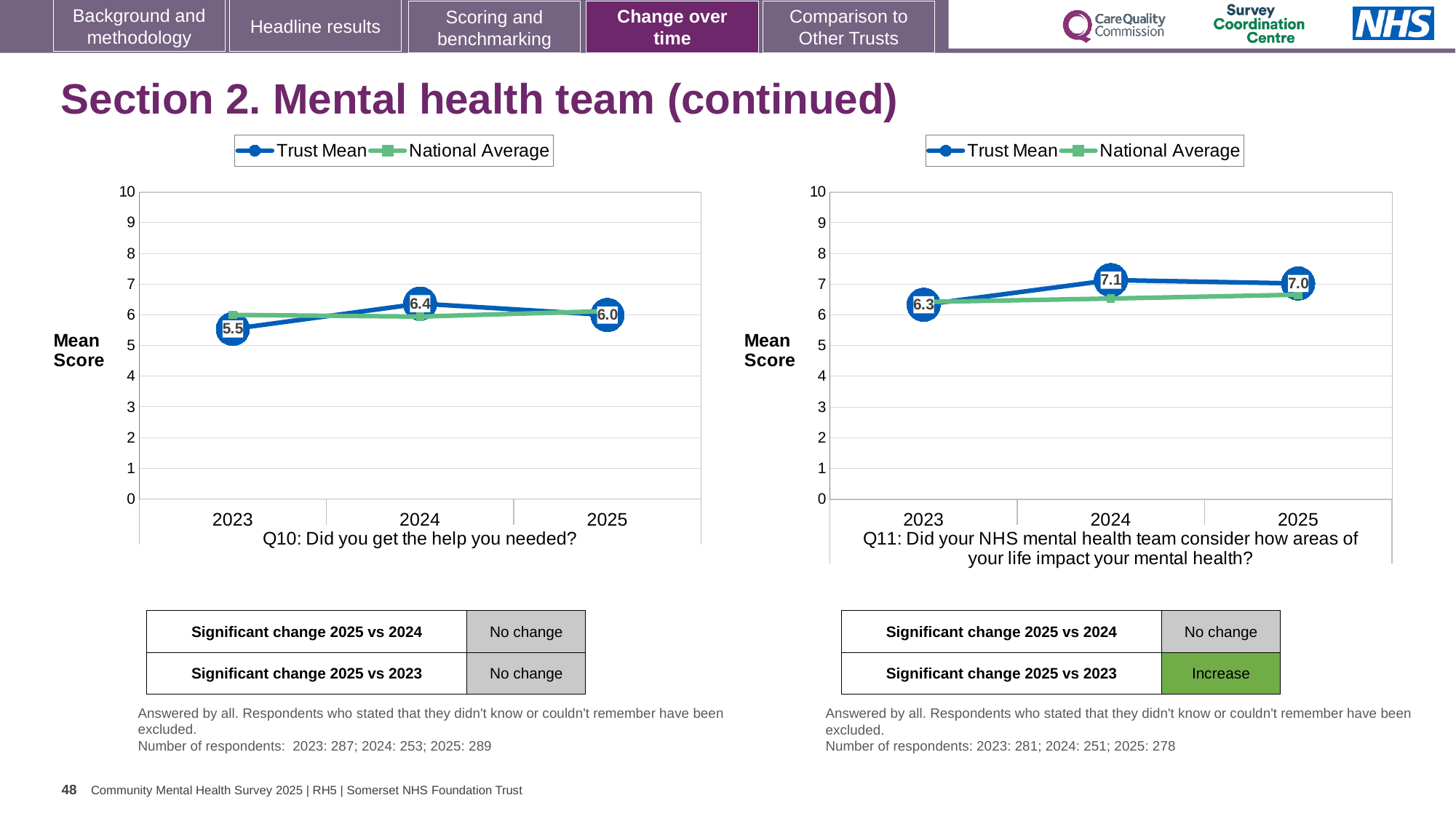
In the Q11 chart (right), what is the difference between the Trust Mean scores for 2024 and 2025? 0.1 In the Q11 chart (right), what is the Trust Mean score for 2025? 7.0 In the Q11 chart (right), which year has the lowest Trust Mean score? 2023 In the Q10 chart (left), what is the Trust Mean score for 2023? 5.5 In the Q10 chart (left), what is the Trust Mean score for 2024? 6.4 In the Q10 chart (left), which year has the highest Trust Mean score? 2024 How many series does the legend of the Q10 chart (left) list? 2 In the Q11 chart (right), is the National Average value for 2025 greater or less than 6? greater What kind of chart is the Q11 chart (right)? Line chart In the Q10 chart (left), is the Trust Mean score higher in 2025 or in 2023? 2025 In the Q10 chart (left), what is the difference between the Trust Mean scores for 2024 and 2023? 0.9 In the Q11 chart (right), what is the Trust Mean score for 2023? 6.3